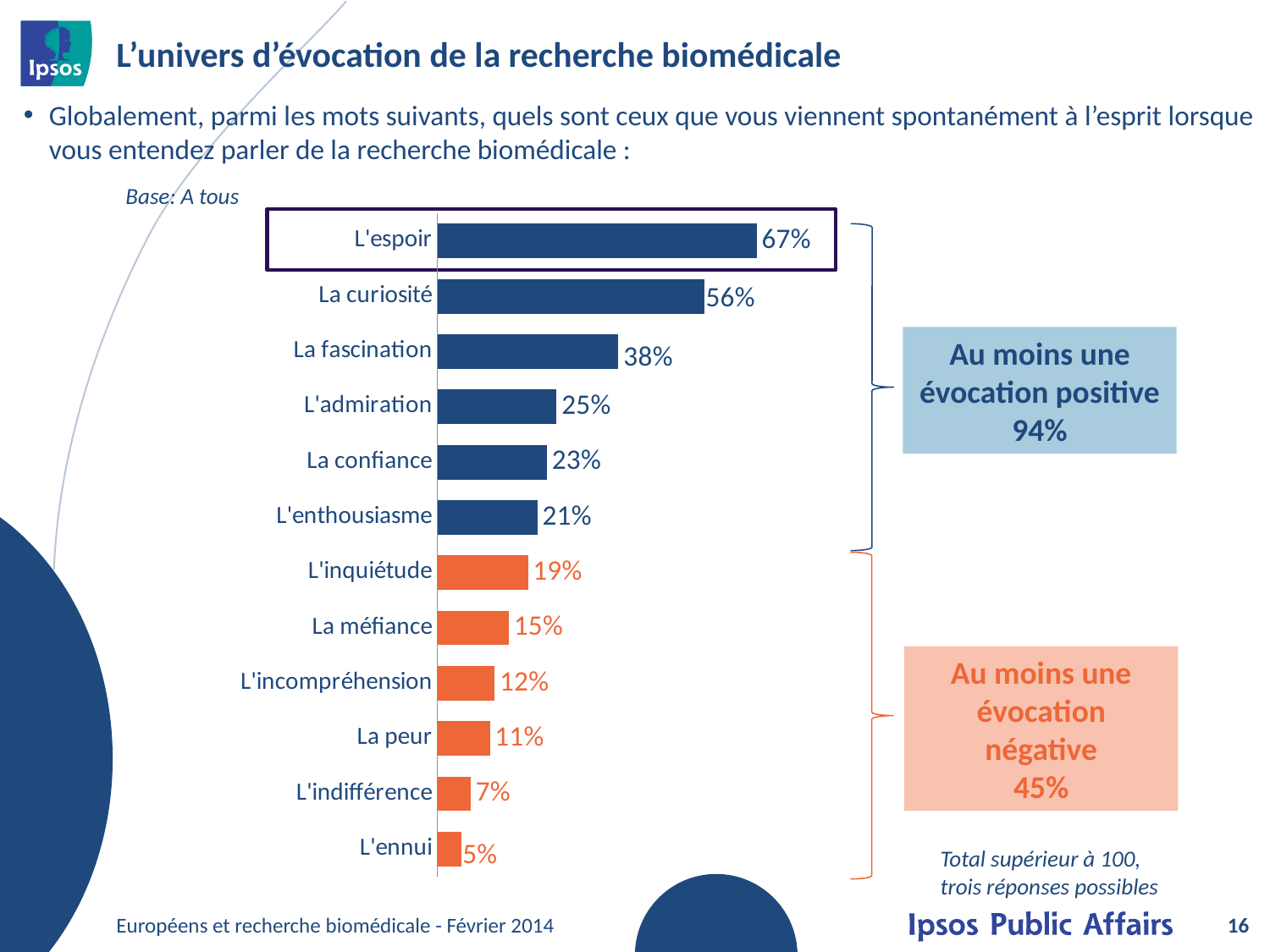
How many categories are shown in the chart? 12 What colour are the bars for the negative evocations such as La peur and L'ennui? Orange What is the difference between the values for L'espoir and La curiosité? 11% What is the value for L'espoir? 67% Which category has the highest value? L'espoir What is the difference between the values for La méfiance and L'indifférence? 8% What is the value for La confiance? 23% What percentage is given for 'Au moins une évocation positive'? 94% Which is larger, the value for La fascination or the value for L'admiration? La fascination What is the value for L'inquiétude? 19% What kind of chart is shown on the slide? Bar chart Which category has the lowest value? L'ennui